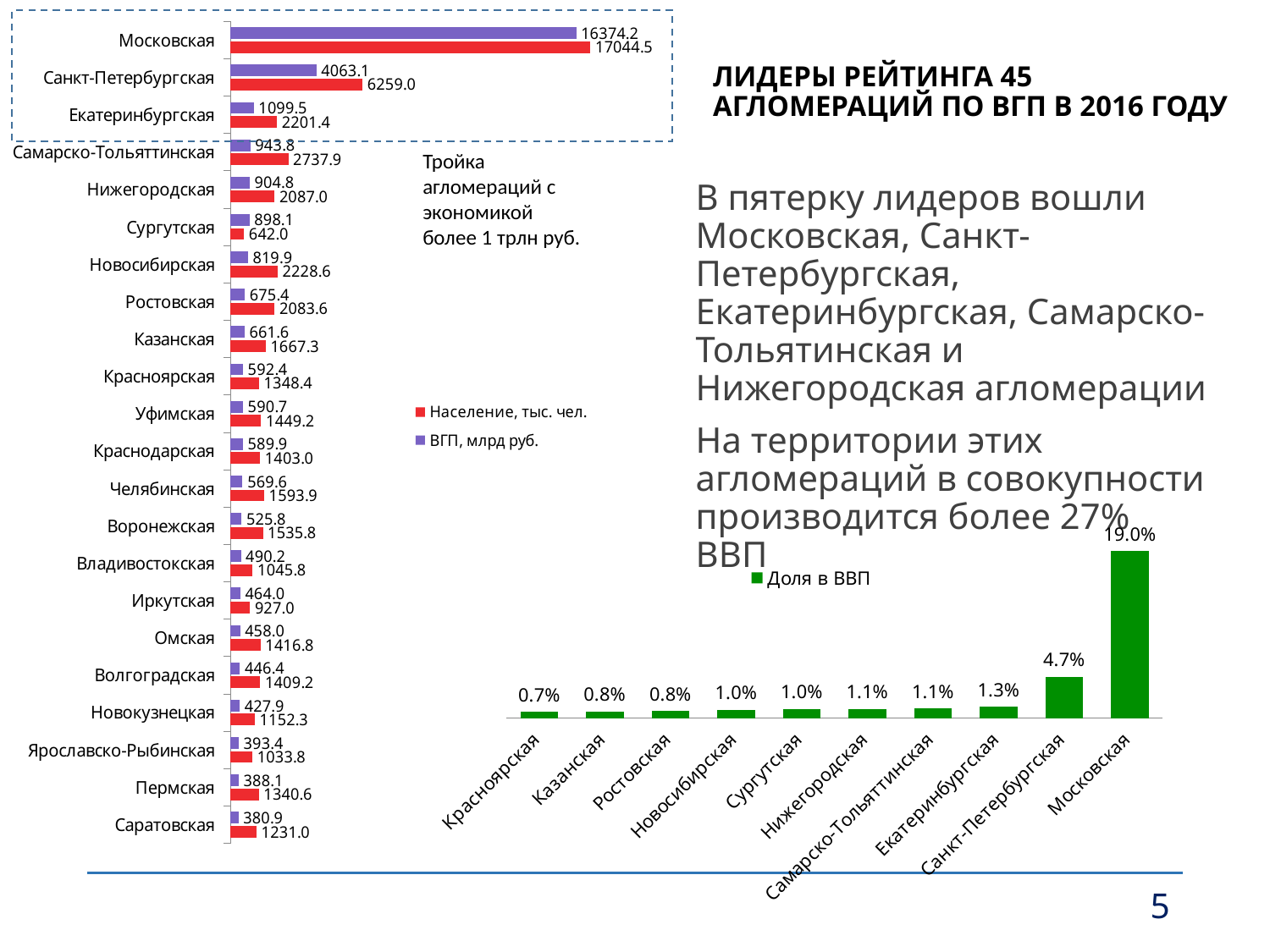
How many agglomerations are shown on the left bar chart? 22 How many series does the legend of the left bar chart list? 2 On the left bar chart, what is the Население, тыс. чел. value for Санкт-Петербургская? 6259.0 What kind of chart is the Доля в ВВП chart at the bottom right? Bar chart On the Доля в ВВП chart, which is larger: Екатеринбургская or Нижегородская? Екатеринбургская On the left bar chart, which agglomeration has the lowest ВГП, млрд руб.? Саратовская On the Доля в ВВП chart, what is the difference between Московская and Санкт-Петербургская? 14.3% On the left bar chart, what is the ВГП, млрд руб. value for Московская? 16374.2 On the Доля в ВВП chart, what is the value for Московская? 19.0% On the left bar chart, which agglomeration has the lowest Население, тыс. чел.? Сургутская On the left bar chart, which agglomeration has the highest ВГП, млрд руб.? Московская On the left bar chart, what is the difference in ВГП, млрд руб. between Московская and Санкт-Петербургская? 12311.1